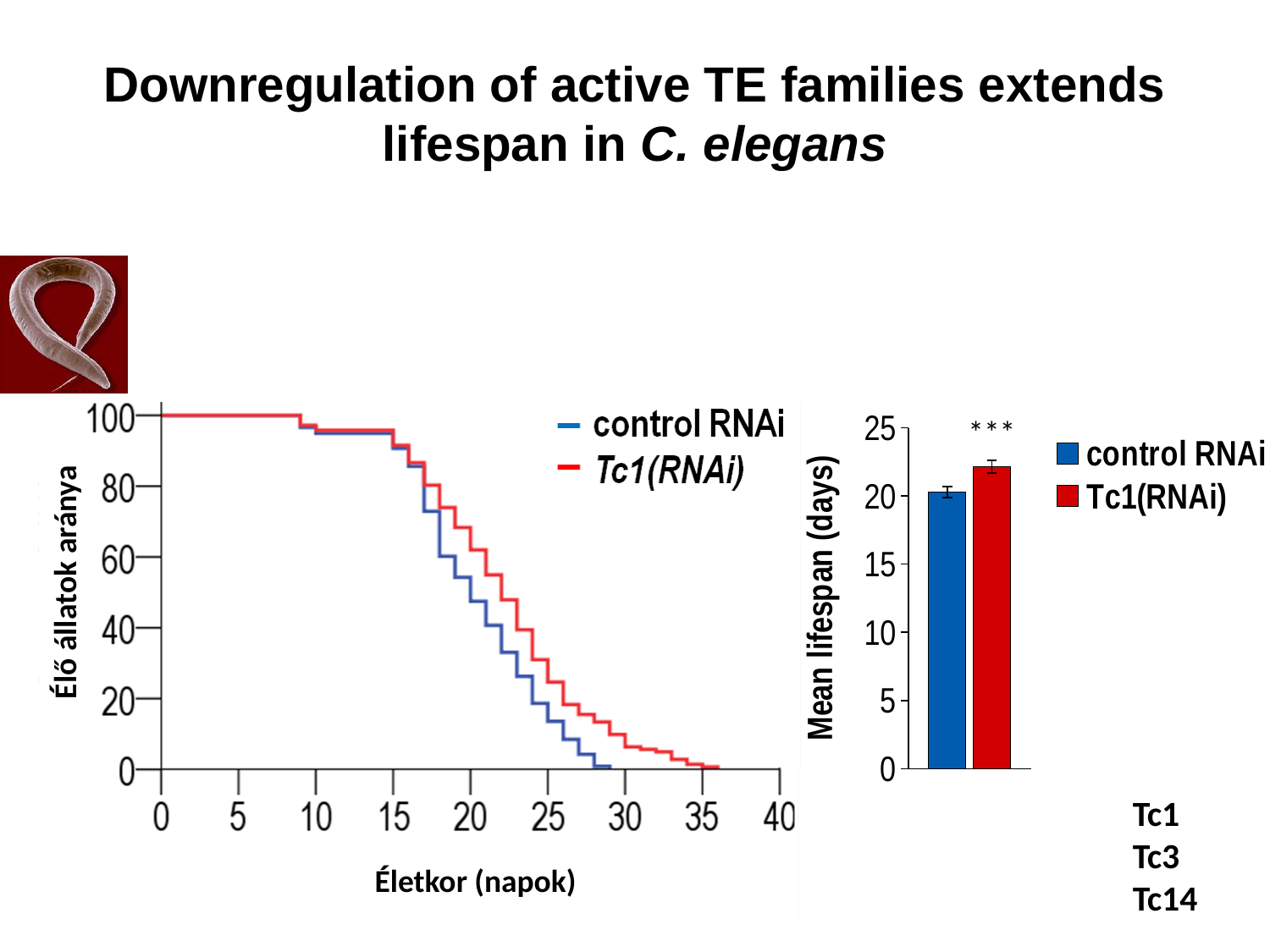
In the bar chart on the right, is the mean lifespan for Tc1(RNAi) greater or less than 25 days? less In the survival chart on the left, what colour is the control RNAi curve? blue How many series does the legend of the bar chart on the right list? 2 In the survival chart on the left, how many series does the legend list? 2 In the survival chart on the left, which series reaches 0% survival at a later age, control RNAi or Tc1(RNAi)? Tc1(RNAi) In the survival chart on the left, do the curves rise or fall as age increases along the x axis? fall In the bar chart on the right, which series has the lower mean lifespan? control RNAi In the bar chart on the right, which series has the higher mean lifespan? Tc1(RNAi) In the bar chart on the right, is the mean lifespan for Tc1(RNAi) greater or less than 20 days? greater In the bar chart on the right, is the mean lifespan for control RNAi greater or less than 15 days? greater What is the y-axis label of the bar chart on the right? Mean lifespan (days) What kind of chart is the chart on the right of the slide? bar chart